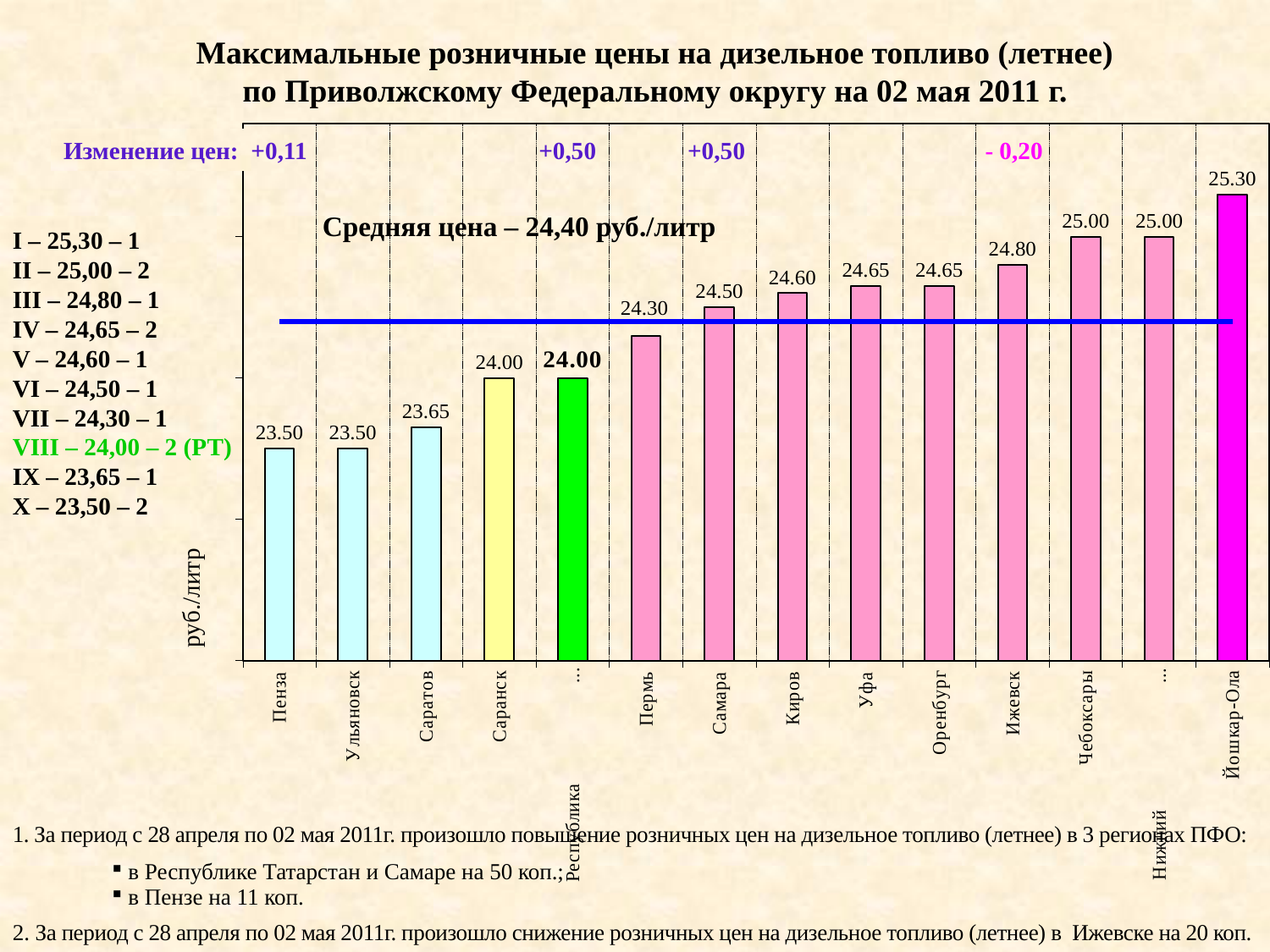
What value is shown for Ижевск? 24.80 What is the difference between the values for Киров and Самара? 0.10 What average price (Средняя цена) is stated on the chart? 24,40 руб./литр Which is larger, the value for Саранск or the value for Саратов? Саранск What kind of chart is shown on the slide? bar chart How many bars (cities) are plotted on the chart? 14 What value is shown for Саратов? 23.65 Which city has the highest bar on the chart? Йошкар-Ола Which is larger, the value for Уфа or the value for Пермь? Уфа What is the difference between the values for Йошкар-Ола and Пенза? 1.80 What value is shown for Пермь? 24.30 What is the maximum retail price of diesel fuel shown for Йошкар-Ола? 25.30